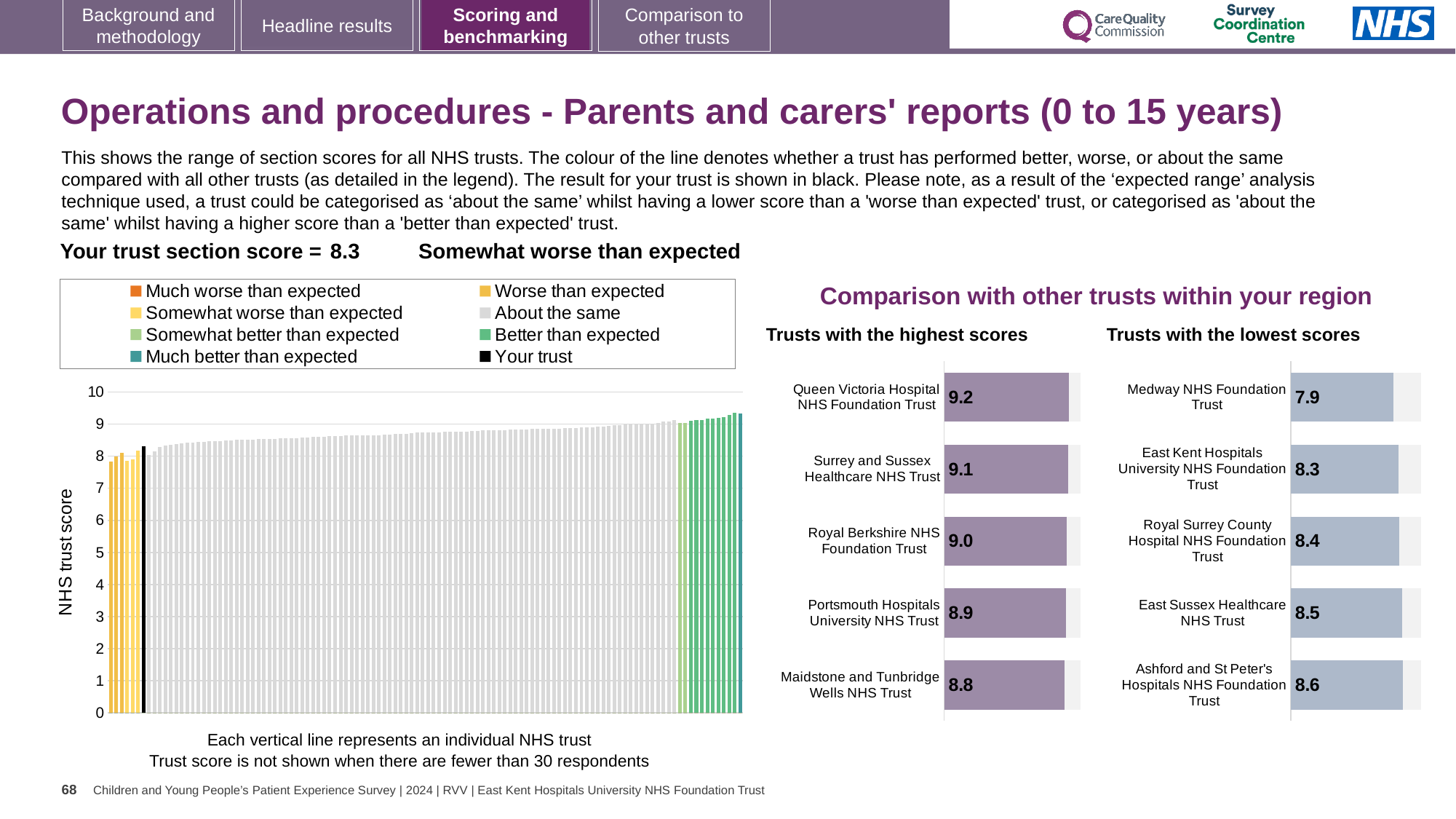
What is the y-axis label of the left-hand bar chart? NHS trust score In the 'Trusts with the lowest scores' chart, which trust has the highest score? Ashford and St Peter's Hospitals NHS Foundation Trust In the 'Trusts with the highest scores' chart, what is the difference between the scores of Queen Victoria Hospital NHS Foundation Trust and Maidstone and Tunbridge Wells NHS Trust? 0.4 In the 'Trusts with the lowest scores' chart, what is the score for Medway NHS Foundation Trust? 7.9 In the 'Trusts with the lowest scores' chart, which has the larger score: Royal Surrey County Hospital NHS Foundation Trust or East Sussex Healthcare NHS Trust? East Sussex Healthcare NHS Trust In the 'Trusts with the lowest scores' chart, what is the score for East Kent Hospitals University NHS Foundation Trust? 8.3 How many trusts are shown in the 'Trusts with the highest scores' chart? 5 In the left-hand 'NHS trust score' chart, is the value for the black 'Your trust' bar greater or less than 5? greater How many entries does the legend of the left-hand 'NHS trust score' chart list? 8 What kind of chart is the 'Trusts with the lowest scores' chart? Bar chart In the 'Trusts with the highest scores' chart, which trust has the lowest score? Maidstone and Tunbridge Wells NHS Trust In the 'Trusts with the highest scores' chart, what is the score for Queen Victoria Hospital NHS Foundation Trust? 9.2